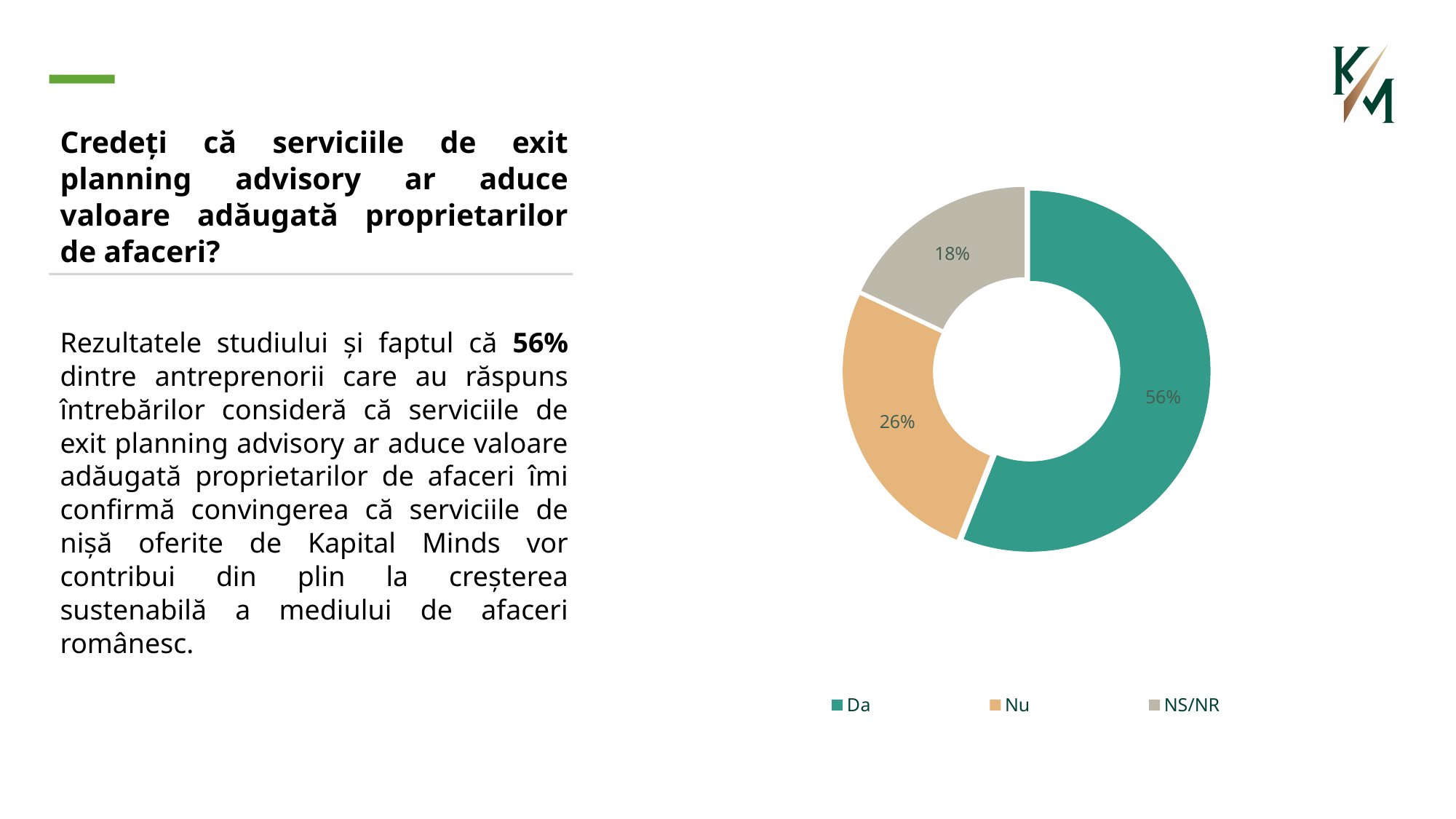
How many categories does the chart show? 3 Which response has the smallest share of the chart? NS/NR What kind of chart is shown on the slide? Pie chart (doughnut) What is the difference in percentage points between the "Da" and "Nu" shares? 30 What colour is the "Da" slice in the chart? Teal green What share of respondents answered "Nu"? 26% What share of respondents answered "Da"? 56% Which response has the largest share of the chart? Da Which is larger, the share for "Nu" or the share for "NS/NR"? Nu What is the difference in percentage points between the "Nu" and "NS/NR" shares? 8 What share of respondents answered "NS/NR"? 18% What are the three legend entries of the chart? Da, Nu, NS/NR